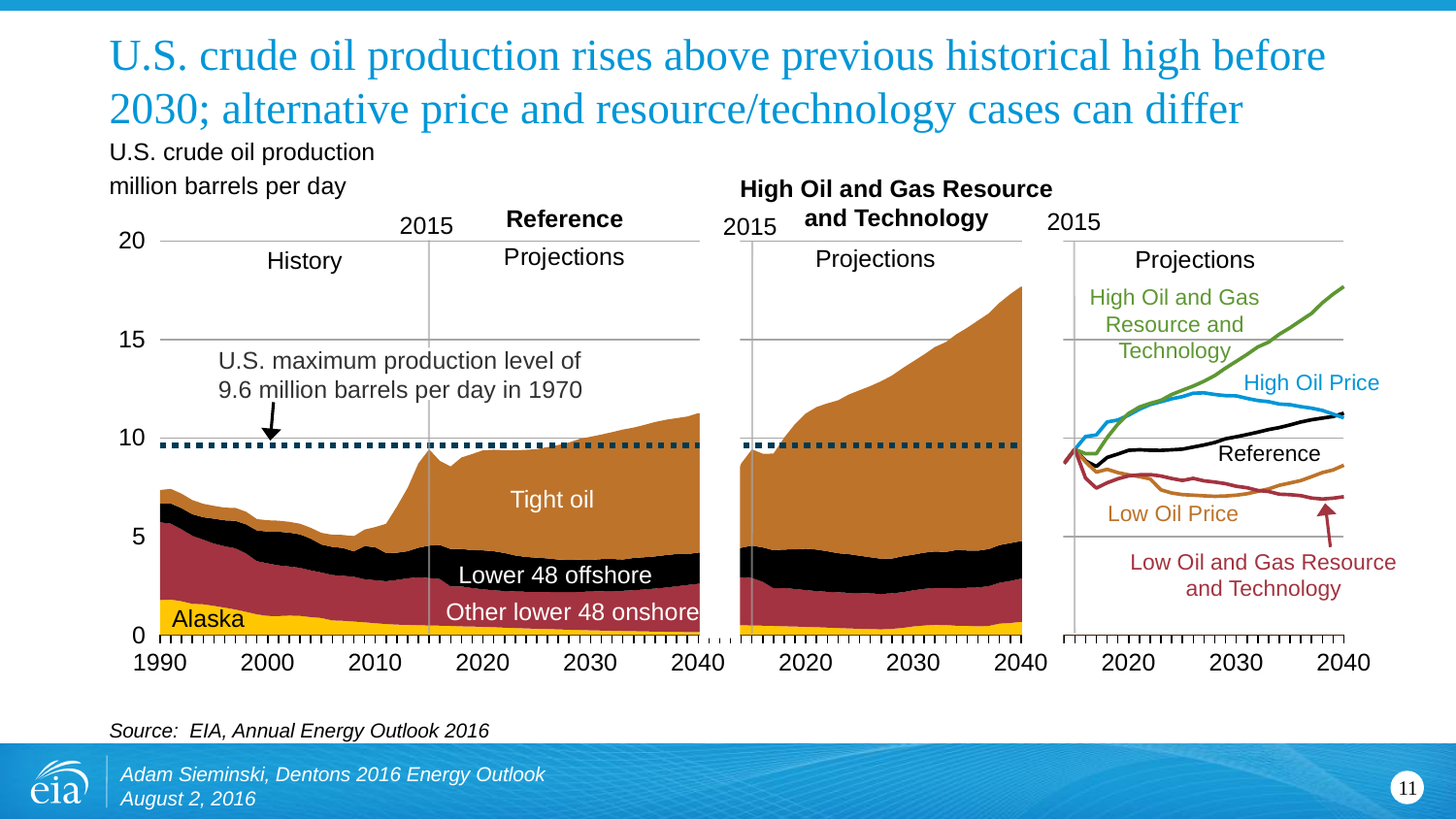
In the Reference panel, does total production rise or fall from 2020 to 2040? rise In the Reference panel, is total production in 2040 greater or less than 10? greater What kind of chart is the rightmost panel showing the scenario comparisons? line chart How many scenario lines are plotted in the rightmost panel? 5 In the rightmost panel, which is larger in 2040: High Oil Price or Low Oil Price? High Oil Price What kind of chart is the Reference panel on the left? stacked area chart In the rightmost panel, which scenario has the lowest production in 2040? Low Oil and Gas Resource and Technology What was the U.S. maximum production level in 1970, according to the annotation? 9.6 million barrels per day Which component is at the bottom of the stack in the Reference panel? Alaska How many production components are stacked in the Reference panel? 4 In the High Oil and Gas Resource and Technology panel, is total production in 2040 greater or less than 15? greater In the rightmost panel, which scenario has the highest production in 2040? High Oil and Gas Resource and Technology